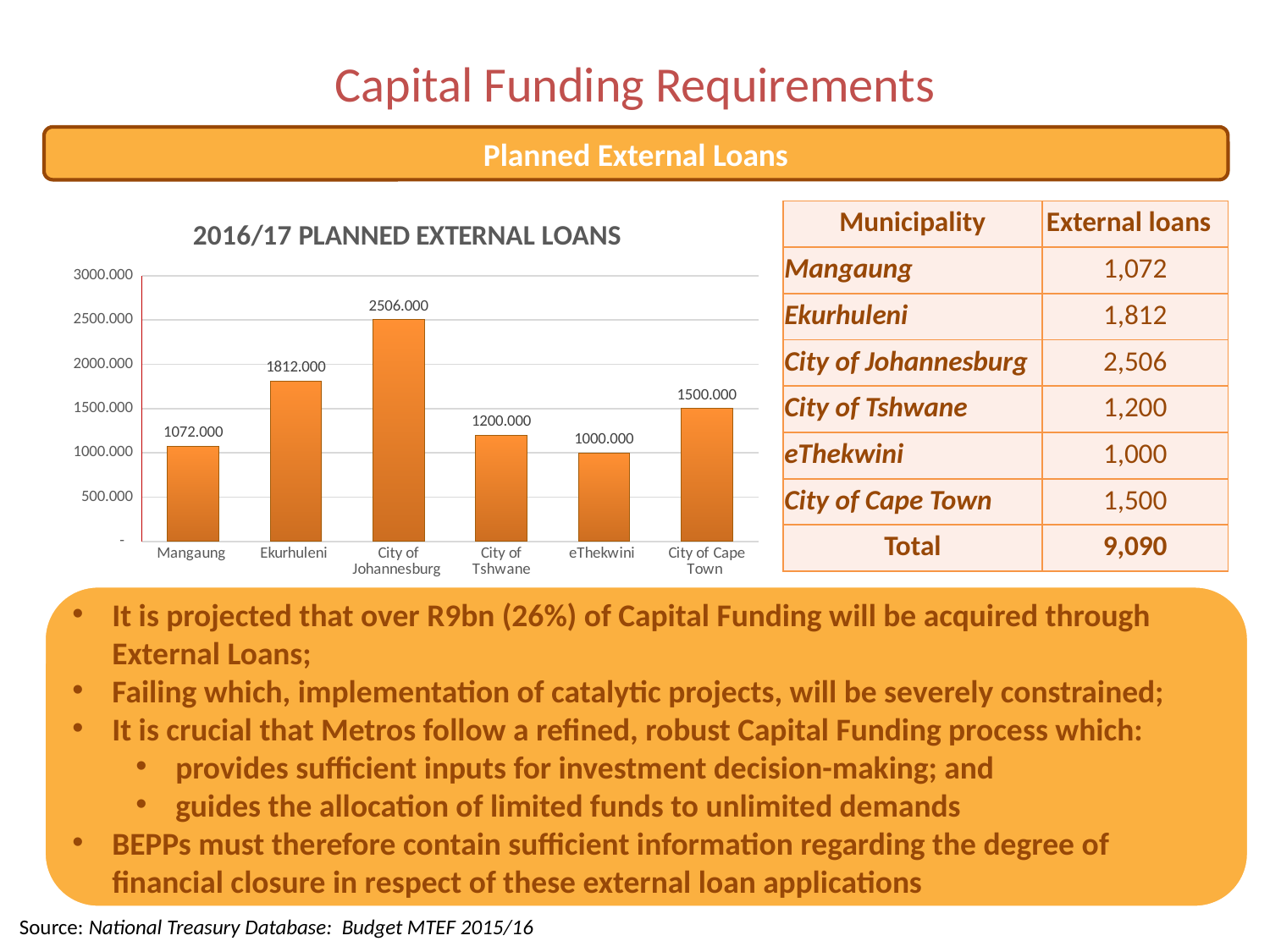
What is the title of the chart on the slide? 2016/17 PLANNED EXTERNAL LOANS What kind of chart is used to show the 2016/17 Planned External Loans? Bar chart Which municipality has the highest planned external loans in the chart? City of Johannesburg What is the difference between the values for Ekurhuleni and Mangaung in the chart? 740.000 Which municipality has the lowest planned external loans in the chart? eThekwini What is the difference between the values for City of Johannesburg and City of Tshwane in the chart? 1306.000 Is the value for Ekurhuleni in the chart greater or less than 2000.000? less What is the value for eThekwini in the 2016/17 Planned External Loans chart? 1000.000 How many municipalities are shown on the x axis of the chart? 6 Which is larger in the chart, the value for City of Tshwane or the value for City of Cape Town? City of Cape Town What is the value for City of Johannesburg in the 2016/17 Planned External Loans chart? 2506.000 What is the value for City of Cape Town in the 2016/17 Planned External Loans chart? 1500.000